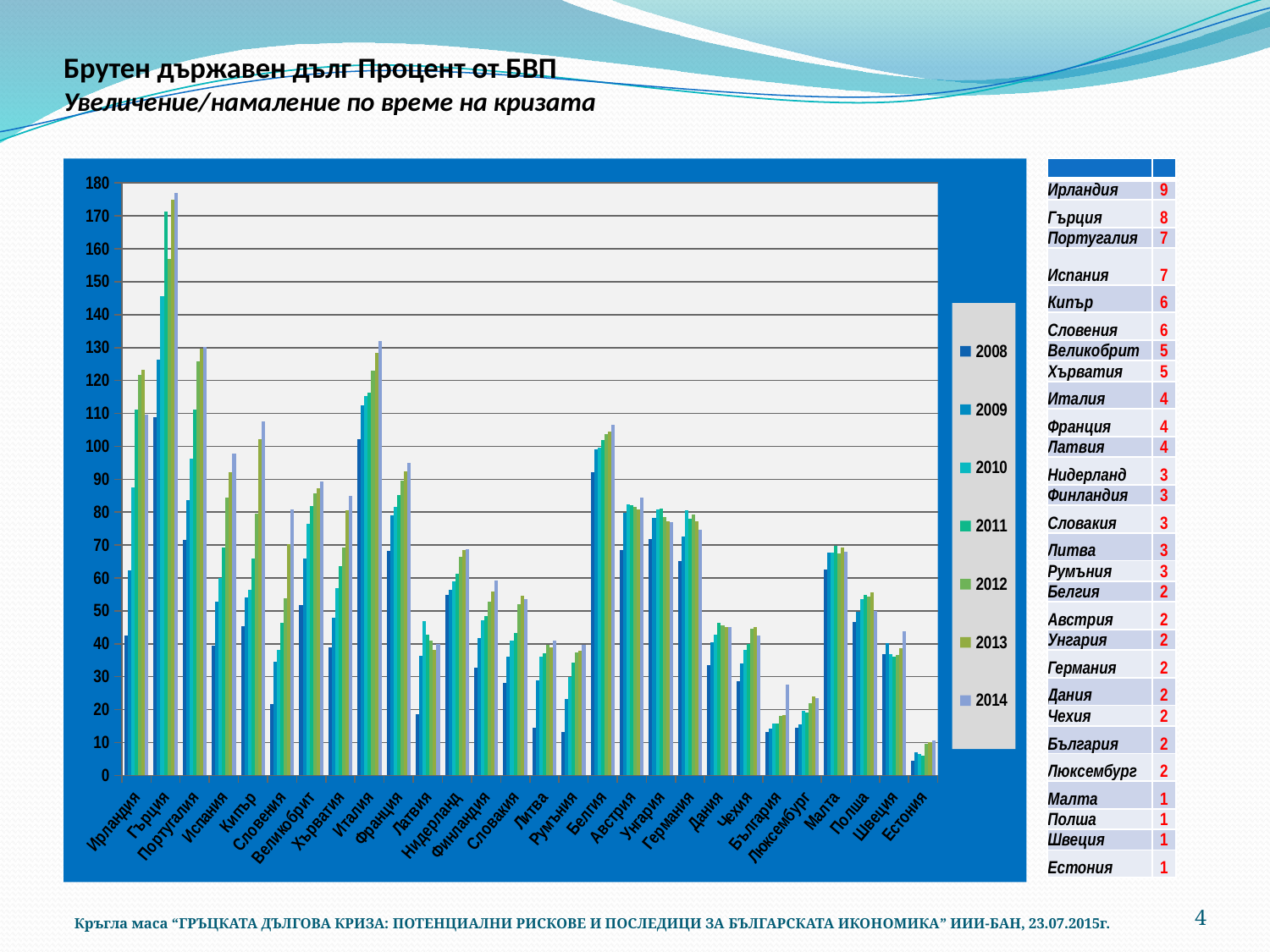
How many series does the chart legend list? 7 Which country has the lowest value for 2014? Естония Which country has the highest value for 2014? Гърция How many countries are shown on the x axis of the chart? 28 Is the value for Италия in 2014 greater or less than 120? greater Is the value for Естония in 2014 greater or less than 20? less Do the values for Италия rise or fall from 2008 to 2014? rise Is the value for Ирландия in 2008 greater or less than 50? less Which year is listed first in the chart legend? 2008 Which is larger in 2014, the value for Италия or the value for Франция? Италия What kind of chart is shown on the slide? bar chart